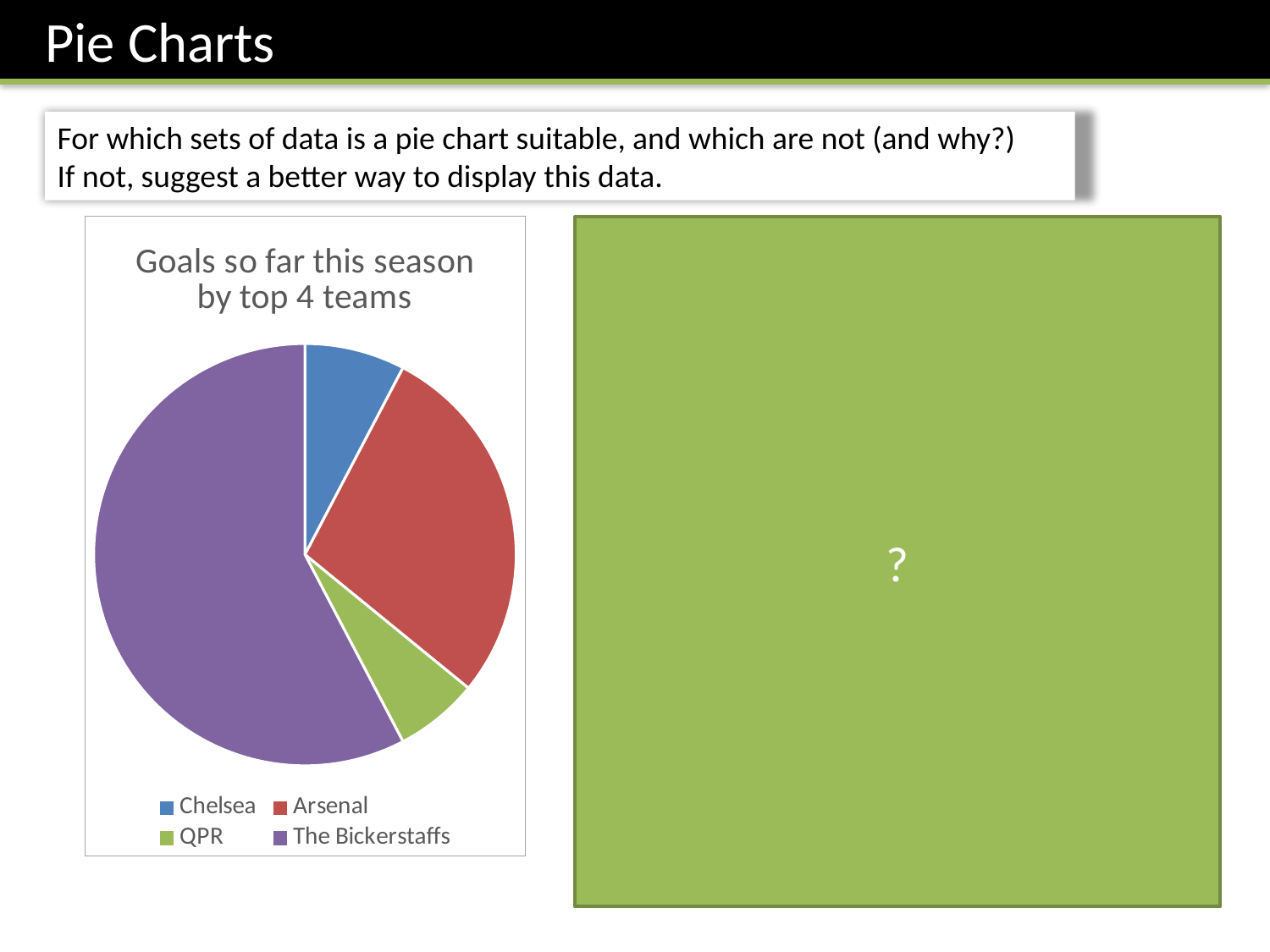
Which slice is larger, The Bickerstaffs or Arsenal? The Bickerstaffs What is the title of the pie chart? Goals so far this season by top 4 teams How many slices does the pie chart have? 4 Which team has the largest slice of the pie chart? The Bickerstaffs Which teams are listed in the legend of the pie chart? Chelsea, Arsenal, QPR, The Bickerstaffs Does The Bickerstaffs' slice make up more or less than half of the pie? more What kind of chart is shown on the slide? pie chart Which colour represents QPR in the pie chart? green Which slice is larger, Arsenal or Chelsea? Arsenal Which slice is larger, Arsenal or QPR? Arsenal